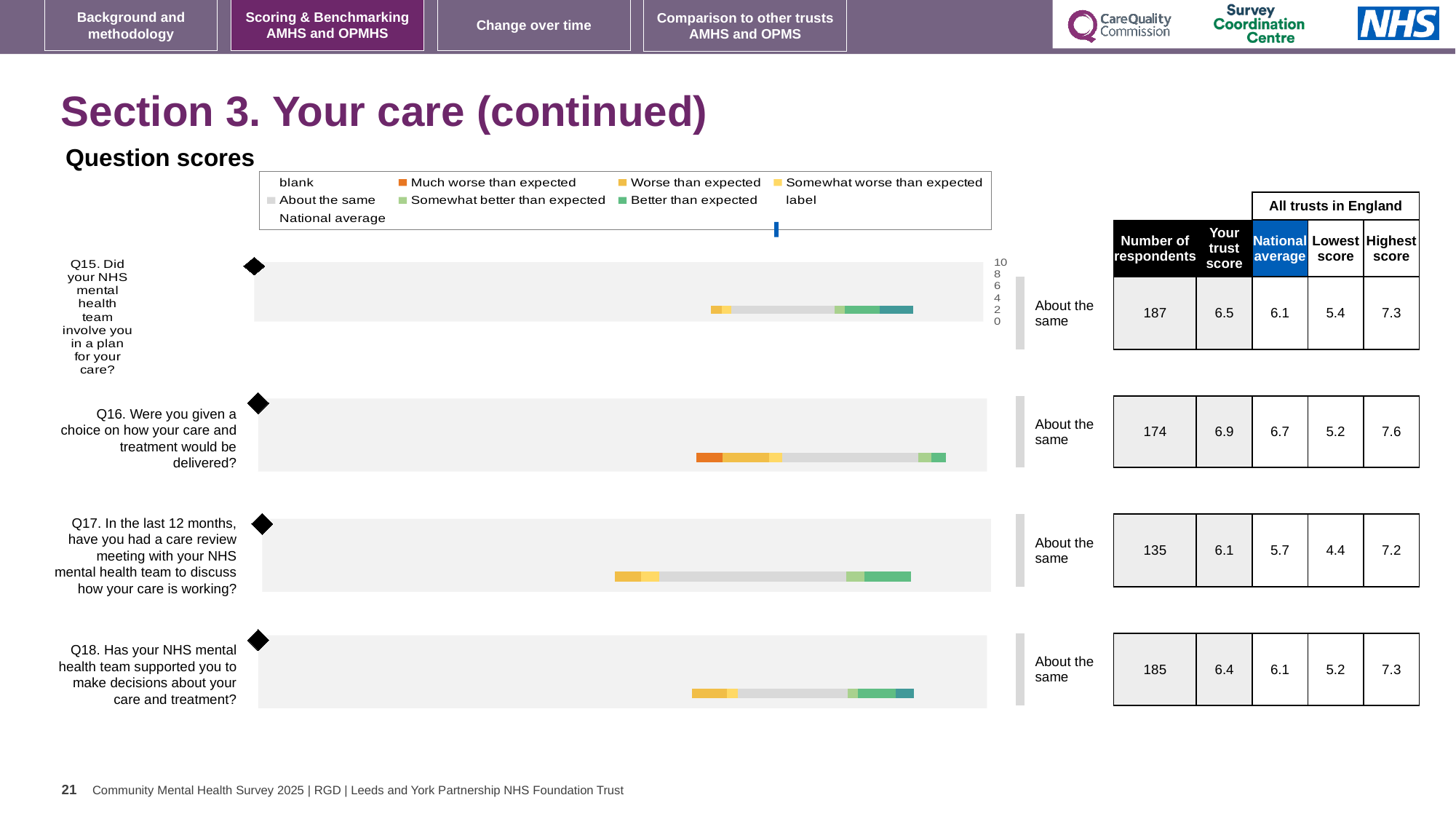
What is the lowest score across all trusts in England for Q17? 4.4 What is the trust score for Q15 (Did your NHS mental health team involve you in a plan for your care?)? 6.5 What comparison category is shown next to each of the four question charts? About the same For Q17, which is larger: the trust score or the national average? Trust score What kind of chart is used to show the question scores for Q15 to Q18? Bar chart What is the national average score for Q16 (Were you given a choice on how your care and treatment would be delivered?)? 6.7 Which question has the lowest number of respondents on this slide? Q17 What is the difference between the trust score and the national average for Q16? 0.2 What is the highest score across all trusts in England for Q18 (supported you to make decisions about your care and treatment)? 7.3 Which question has the highest trust score on this slide? Q16 How many questions (Q15 to Q18) have a score chart on the slide? 4 How many respondents answered Q17 (care review meeting in the last 12 months)? 135